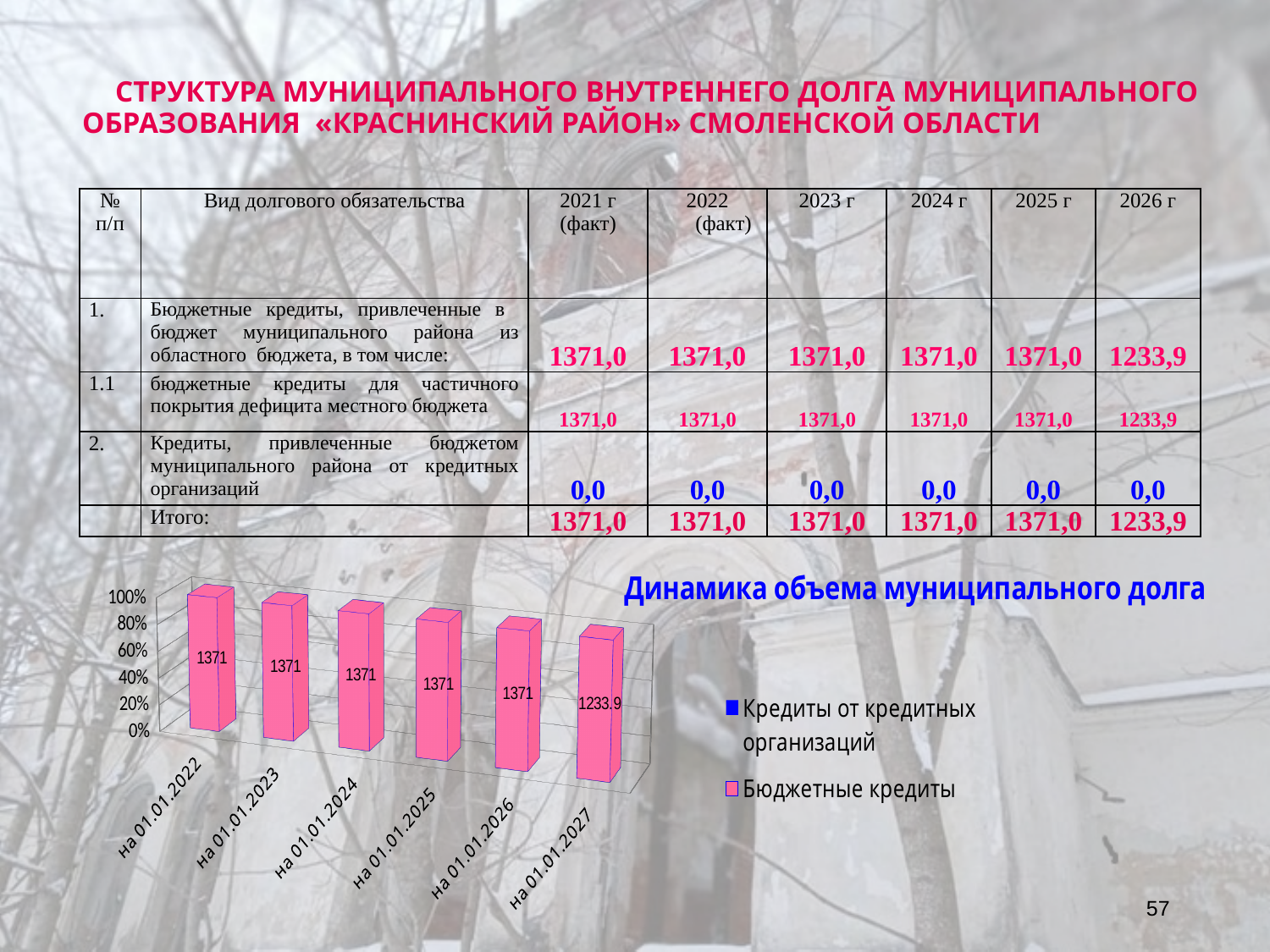
Which category has the lowest labelled value in the chart? на 01.01.2027 Do the labelled values rise or fall from на 01.01.2026 to на 01.01.2027? fall What is the value labelled on the bar for на 01.01.2027? 1233.9 Which legend entry is shown in pink in the chart? Бюджетные кредиты How many categories are shown on the x axis of the chart? 6 What is the title of the chart on the slide? Динамика объема муниципального долга What kind of chart is shown under the table? bar chart What is the value labelled on the bar for на 01.01.2022? 1371 How many series does the chart legend list? 2 How many categories in the chart have a labelled value of 1371? 5 Which is larger, the labelled value for на 01.01.2023 or for на 01.01.2027? на 01.01.2023 What is the difference between the labelled values for на 01.01.2026 and на 01.01.2027? 137.1